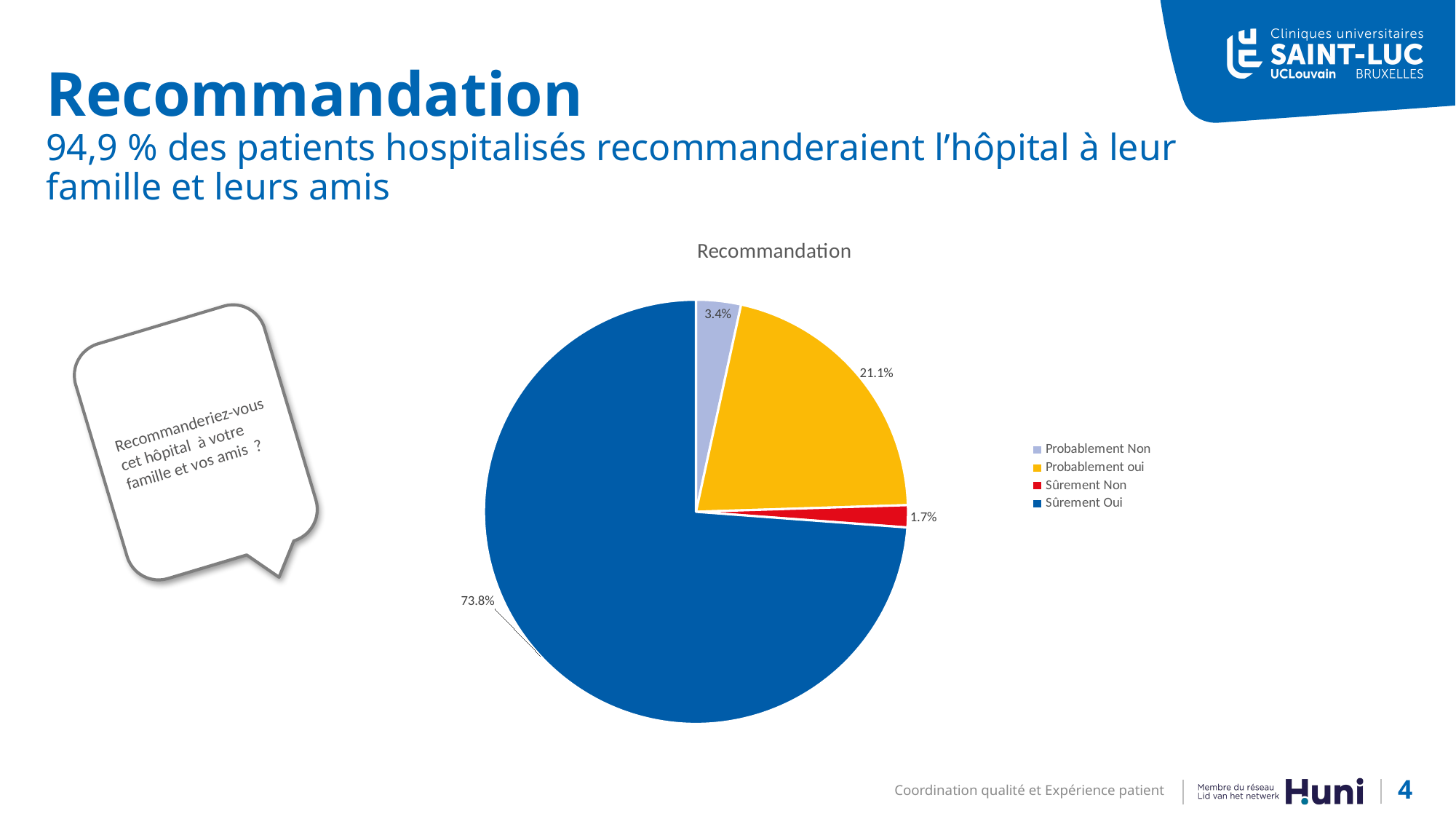
What percentage of the pie is labelled for Sûrement Non? 1.7% What is the difference in percentage points between the Sûrement Oui slice and the Probablement oui slice? 52.7 What colour is the Sûrement Non slice? red What is the chart's title? Recommandation Which is larger, the slice for Probablement oui or the slice for Probablement Non? Probablement oui Which category has the smallest slice of the pie? Sûrement Non Which category has the largest slice of the pie? Sûrement Oui What percentage of the pie is labelled for Sûrement Oui? 73.8% What percentage of the pie is labelled for Probablement oui? 21.1% What percentage of the pie is labelled for Probablement Non? 3.4% How many categories does the legend list? 4 What kind of chart is shown on the slide? pie chart